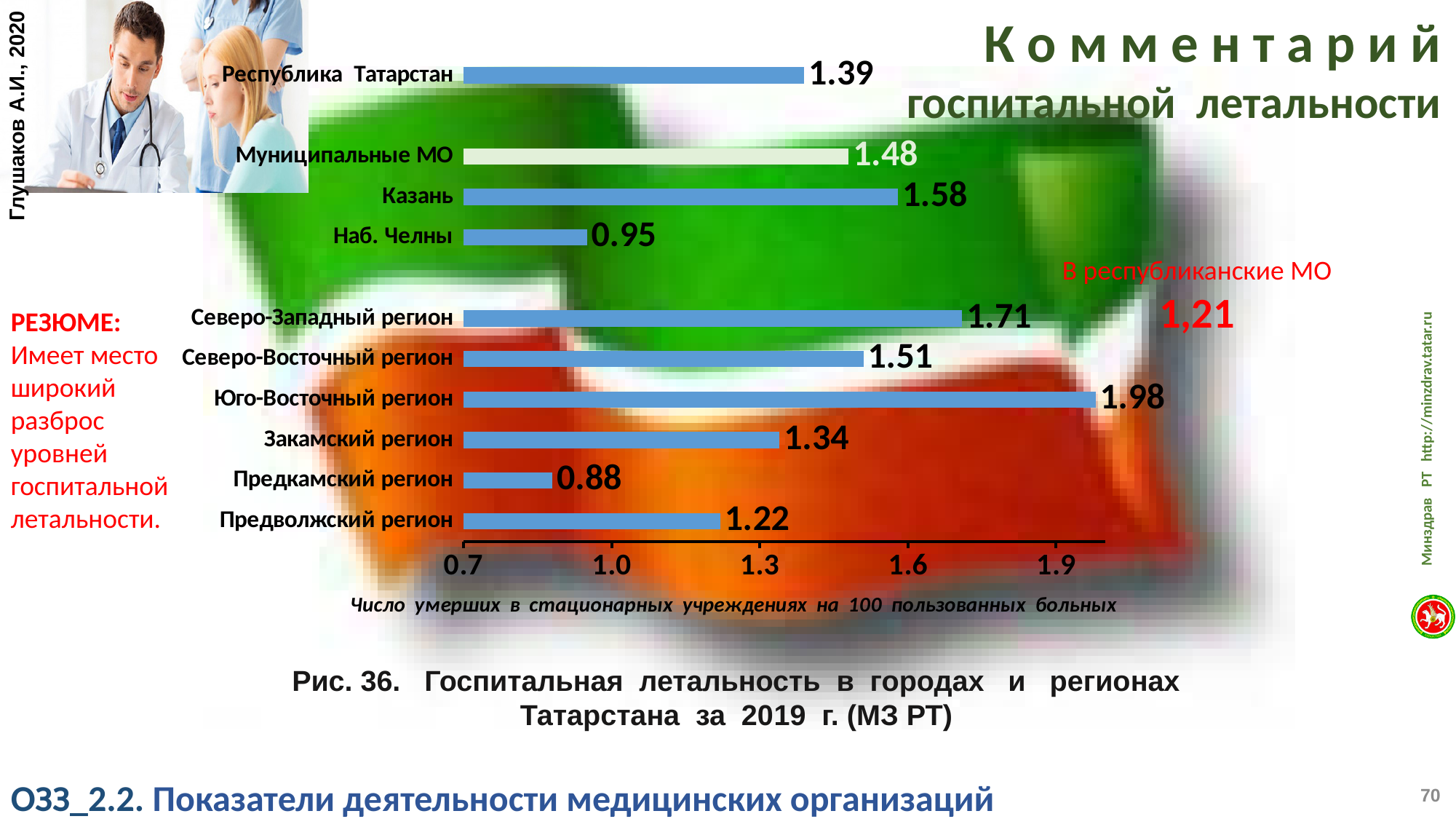
What is the value for Муниципальные МО? 1.48 What is the difference between the values for Юго-Восточный регион and Предволжский регион? 0.76 What is the value for Республика Татарстан? 1.39 How many bars are plotted in the chart? 10 What is the difference between the values for Казань and Наб. Челны? 0.63 Is the value for Закамский регион greater or less than 1.3? greater What is the value for Юго-Восточный регион? 1.98 Which is larger, the value for Северо-Западный регион or the value for Северо-Восточный регион? Северо-Западный регион Which category has the highest value? Юго-Восточный регион Which category has the lowest value? Предкамский регион What kind of chart is shown on the slide? bar chart What is the value for Наб. Челны? 0.95